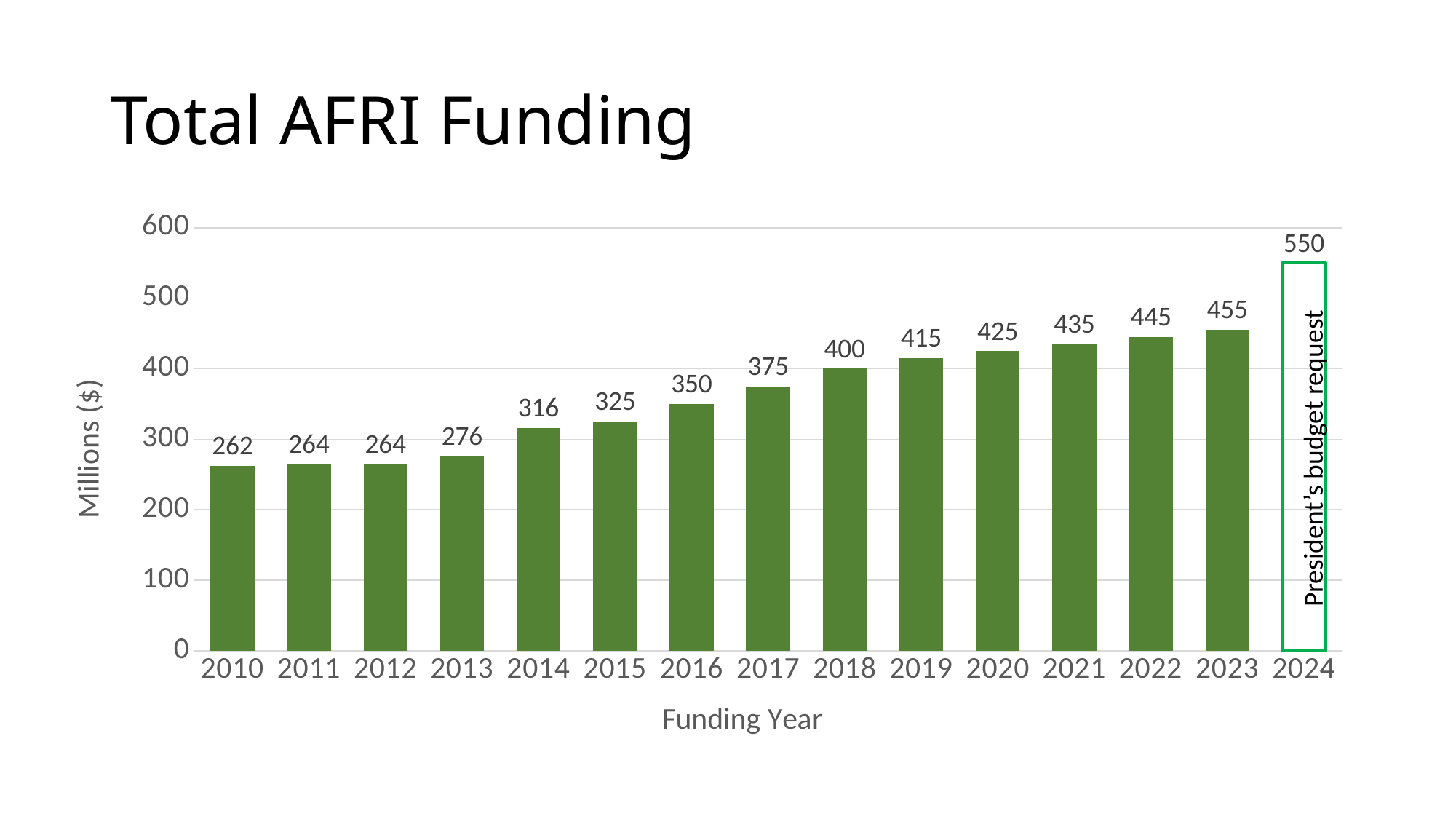
Do the values rise or fall from 2010 to 2024? rise Which year has the lowest value? 2010 Which is larger, the value for 2013 or the value for 2015? 2015 What is the difference between the values for 2023 and 2010? 193 What is the value for 2014? 316 What is the label on the y axis? Millions ($) What is the value for 2018? 400 What is the difference between the values for 2017 and 2016? 25 What kind of chart is this? bar chart How many years are shown on the x axis? 15 Which year has the highest value? 2024 What is the value shown for 2024? 550